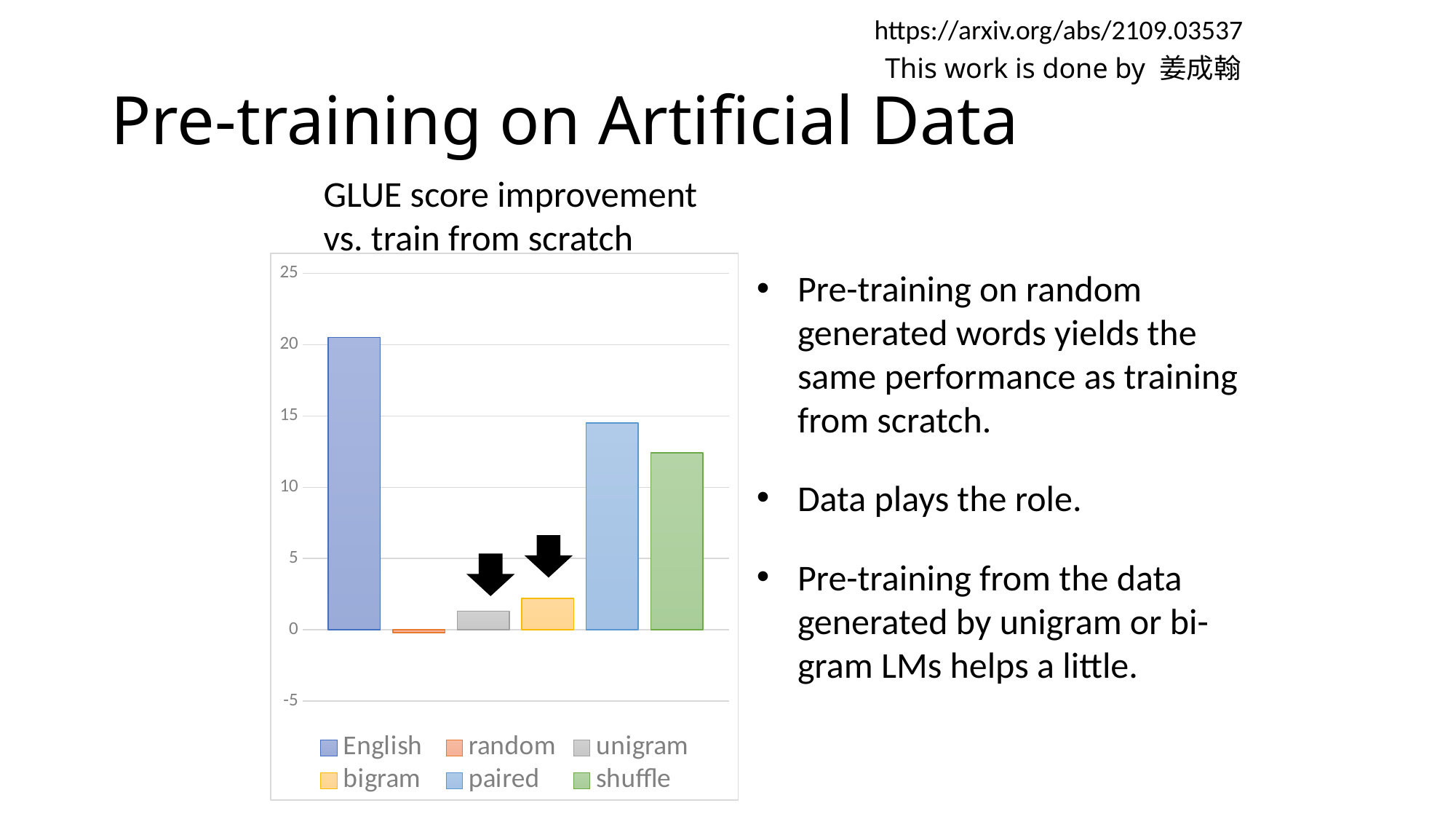
Which series has the highest GLUE score improvement? English What kind of chart is shown on the slide? bar chart How many bars are plotted in the chart? 6 Is the value for paired greater or less than 10? greater What is the title of the chart? GLUE score improvement vs. train from scratch Is the value for English greater or less than 15? greater How many series does the chart legend list? 6 Which is larger, the value for unigram or the value for bigram? bigram Is the value for bigram greater or less than 5? less Which is larger, the value for paired or the value for shuffle? paired Which series has the lowest GLUE score improvement? random